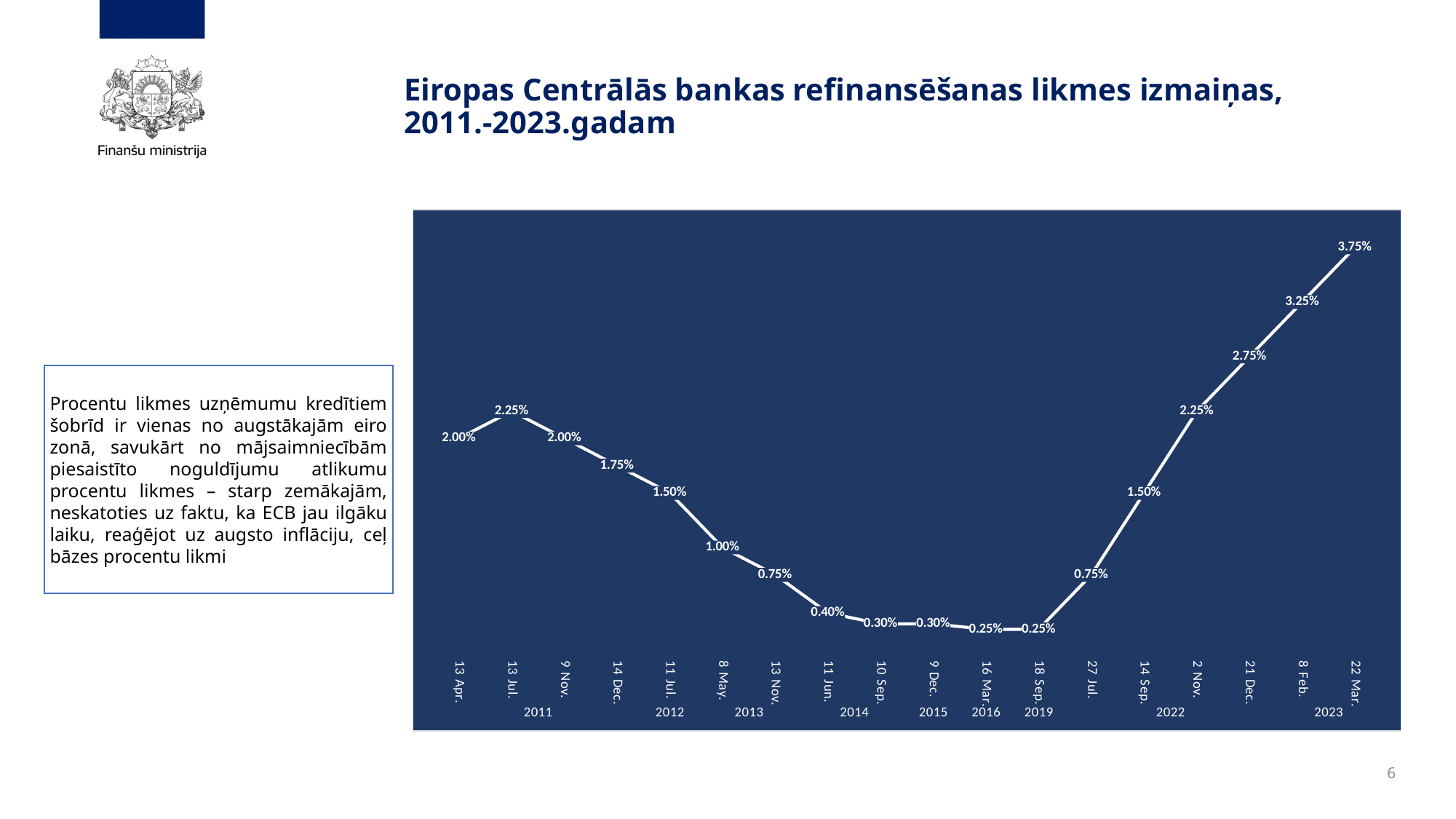
What is the value for 13 Jul. 2011? 2.25% What is the value for 11 Jul. 2012? 1.50% Which is larger, the value for 13 Apr. 2011 or the value for 2 Nov. 2022? 2 Nov. 2022 What is the value for 27 Jul. 2022? 0.75% What is the lowest value plotted on the chart? 0.25% Do the values rise or fall between 13 Jul. 2011 and 16 Mar. 2016? fall How many data points are plotted on the chart? 18 What kind of chart is shown on the slide? line chart By how many percentage points does the value for 22 Mar. 2023 exceed the value for 8 Feb. 2023? 0.50 percentage points On which date does the chart reach its highest value? 22 Mar. 2023 What is the highest value plotted on the chart? 3.75% What is the value for 11 Jun. 2014? 0.40%